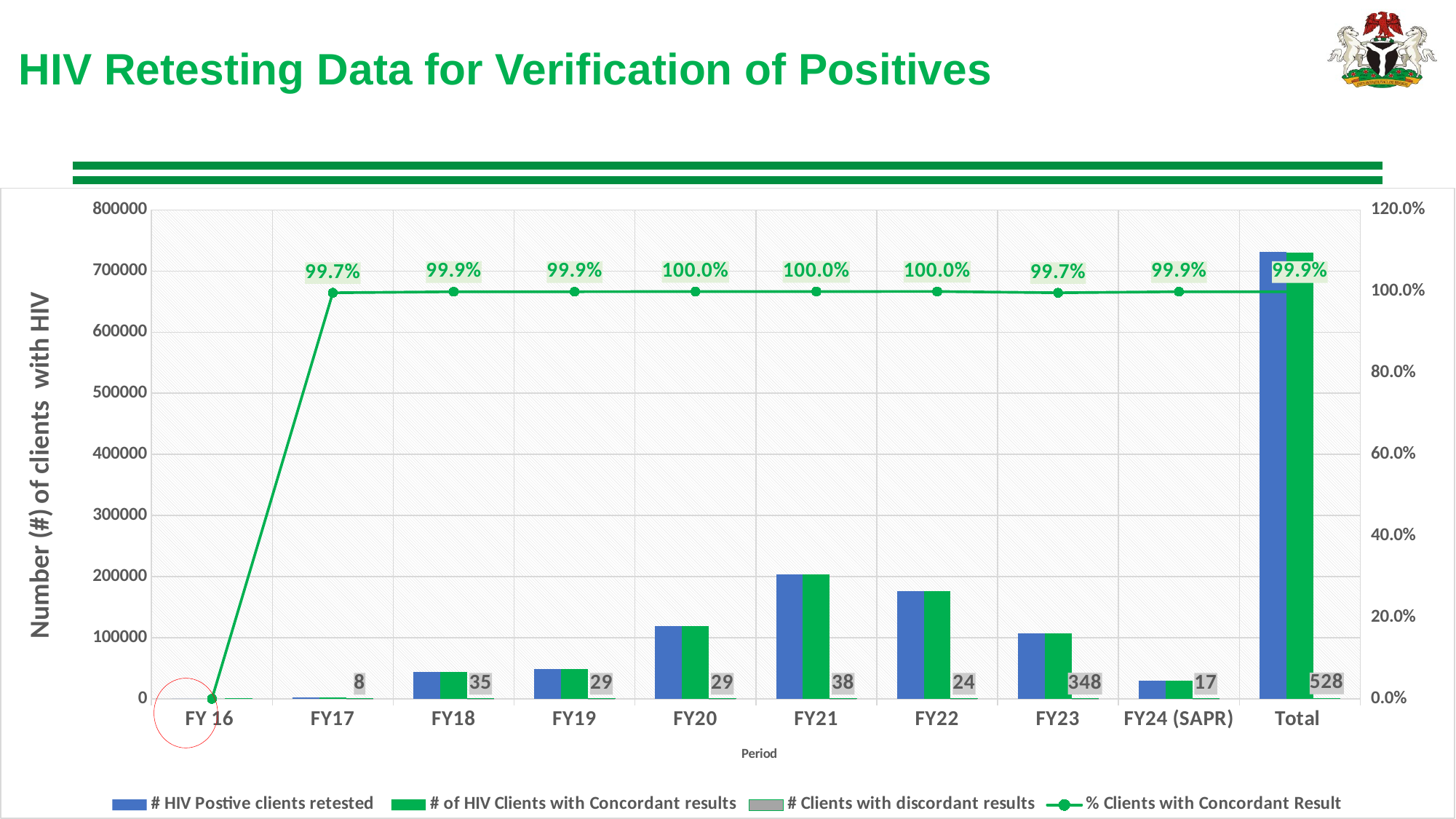
How many series does the legend list? 4 What is the % Clients with Concordant Result for FY21? 100.0% Is the number of HIV positive clients retested in FY21 greater or less than 100000? greater What kind of chart is shown on the slide? Combined bar and line chart Excluding the Total period, which fiscal year has the tallest bar for # HIV Postive clients retested? FY21 How many periods are shown on the x axis? 10 Excluding the Total period, which fiscal year has the highest number of clients with discordant results? FY23 What is the difference between the number of clients with discordant results in FY23 and FY24 (SAPR)? 331 What is the number of clients with discordant results for FY23? 348 What is the % Clients with Concordant Result for FY17? 99.7% Which fiscal year has the lowest labelled number of clients with discordant results? FY17 What is the number of clients with discordant results for the Total period? 528